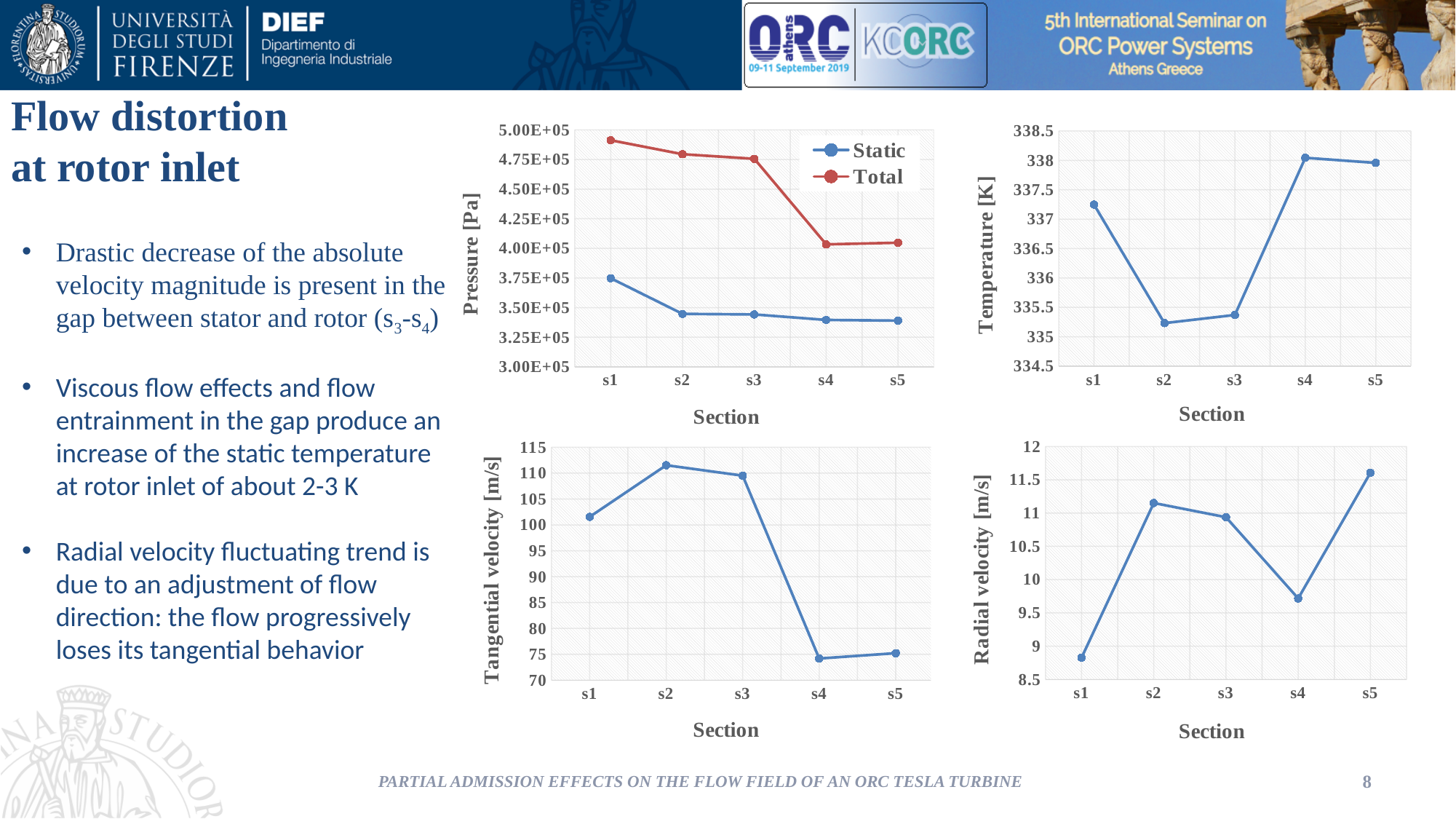
In the Pressure chart, which section has the highest Total pressure? s1 In the Pressure chart, what are the names of the two series in the legend? Static and Total In the Pressure chart, is the Static pressure at s5 greater or less than 3.50E+05? less In the Radial velocity chart, which section has the lowest value? s1 In the Radial velocity chart, how many sections are plotted on the x axis? 5 In the Temperature chart, is the value at s2 greater or less than 335.5? less In the Pressure chart, is the Total pressure at s1 greater or less than 4.75E+05? greater In the Pressure chart, which section has the highest Static pressure? s1 In the Pressure chart, how many series does the legend list? 2 In the Tangential velocity chart, which section has the highest value? s2